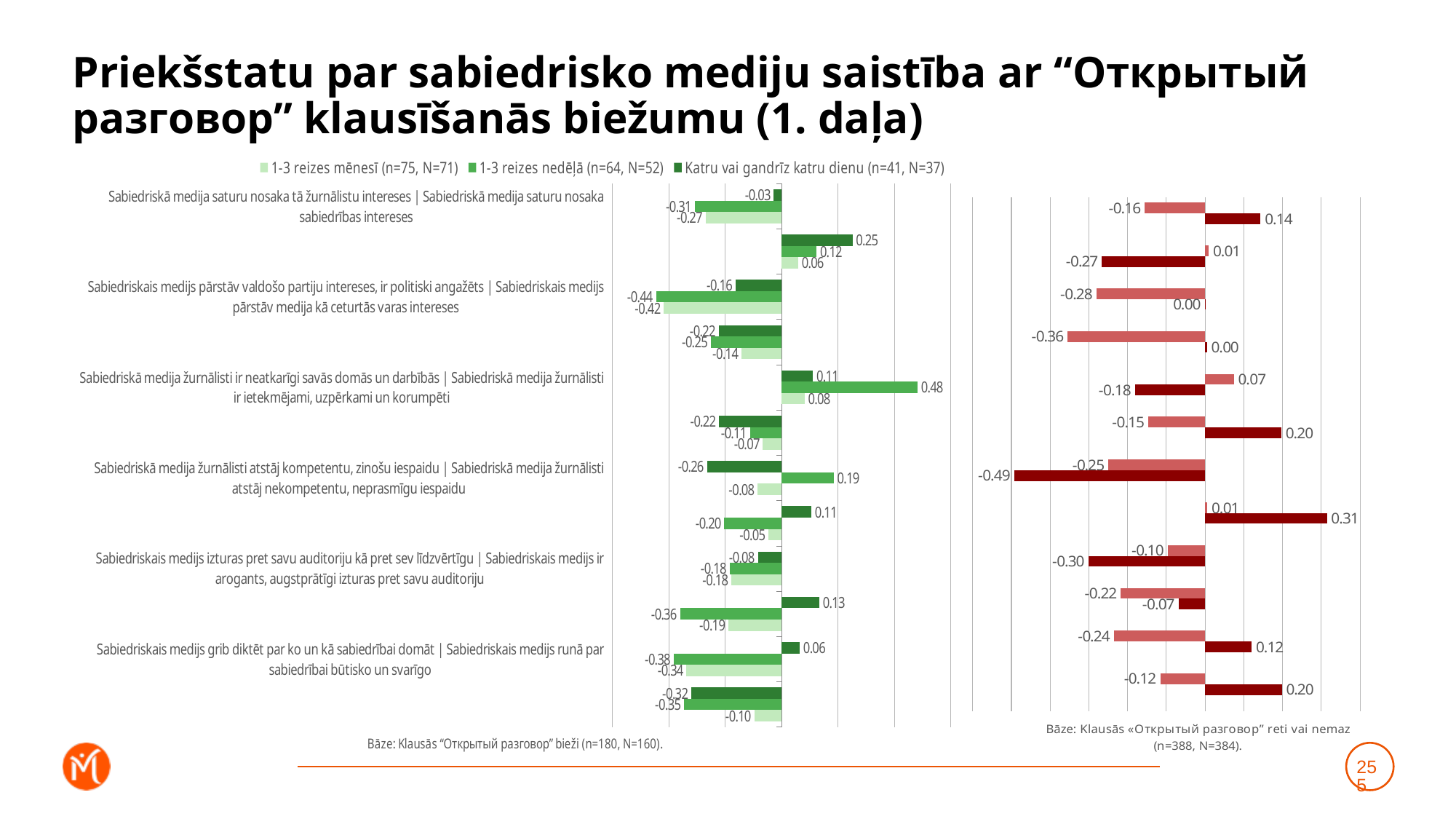
What kind of chart is the left-hand (green) chart? bar chart In the right-hand (red) chart, what is the highest value shown on any bar? 0.31 How many series does the legend of the left-hand (green) chart list? 3 In the left-hand (green) chart, what is the value of the 'Katru vai gandrīz katru dienu' series for 'Sabiedriskā medija saturu nosaka tā žurnālistu intereses | Sabiedriskā medija saturu nosaka sabiedrības intereses'? -0.03 According to the legend of the left-hand (green) chart, what sample sizes are given for the '1-3 reizes mēnesī' series? n=75, N=71 In the left-hand (green) chart, for 'Sabiedriskais medijs grib diktēt par ko un kā sabiedrībai domāt | Sabiedriskais medijs runā par sabiedrībai būtisko un svarīgo', which is larger: the '1-3 reizes nedēļā' value or the '1-3 reizes mēnesī' value? 1-3 reizes mēnesī In the left-hand (green) chart, for 'Sabiedriskā medija žurnālisti atstāj kompetentu, zinošu iespaidu | Sabiedriskā medija žurnālisti atstāj nekompetentu, neprasmīgu iespaidu', what is the difference between the '1-3 reizes nedēļā' value (0.19) and the 'Katru vai gandrīz katru dienu' value (-0.26)? 0.45 In the right-hand (red) chart, what is the lowest value shown on any bar? -0.49 In the left-hand (green) chart, what is the value of the '1-3 reizes mēnesī' series for 'Sabiedriskais medijs pārstāv valdošo partiju intereses, ir politiski angažēts | Sabiedriskais medijs pārstāv medija kā ceturtās varas intereses'? -0.42 In the left-hand (green) chart, what is the highest value shown on any bar? 0.48 In the left-hand (green) chart, what is the value of the '1-3 reizes nedēļā' series for 'Sabiedriskā medija žurnālisti ir neatkarīgi savās domās un darbībās | Sabiedriskā medija žurnālisti ir ietekmējami, uzpērkami un korumpēti'? 0.48 In the left-hand (green) chart, what is the lowest value shown on any bar? -0.44